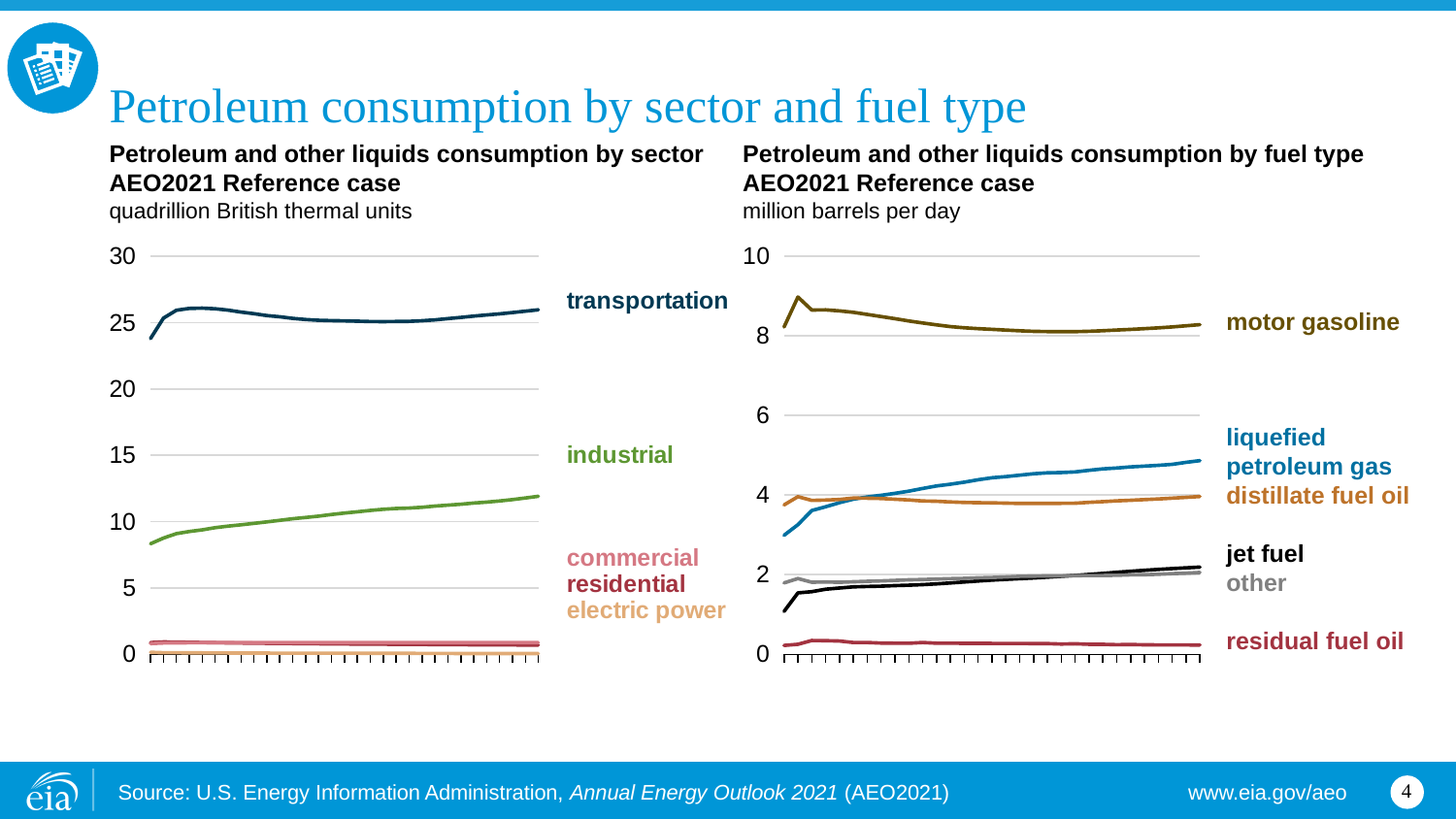
On the right chart (consumption by fuel type), is the value for motor gasoline greater or less than 6? greater How many series are labelled on the left chart, 'Petroleum and other liquids consumption by sector'? 5 On the right chart (consumption by fuel type), which fuel type has the highest consumption? motor gasoline On the left chart (consumption by sector), which sector has the highest consumption? transportation How many series are labelled on the right chart, 'Petroleum and other liquids consumption by fuel type'? 6 What unit is used on the right chart, 'Petroleum and other liquids consumption by fuel type'? million barrels per day On the right chart (consumption by fuel type), which fuel type has the lowest consumption? residual fuel oil On the left chart (consumption by sector), is the value for industrial greater or less than 15? less What kind of chart is the 'Petroleum and other liquids consumption by sector' chart on the left? line chart On the left chart (consumption by sector), is the value for transportation greater or less than 20? greater On the right chart (consumption by fuel type), which is larger at the right end of the chart: liquefied petroleum gas or jet fuel? liquefied petroleum gas On the left chart (consumption by sector), does industrial consumption rise or fall along the x axis? rise